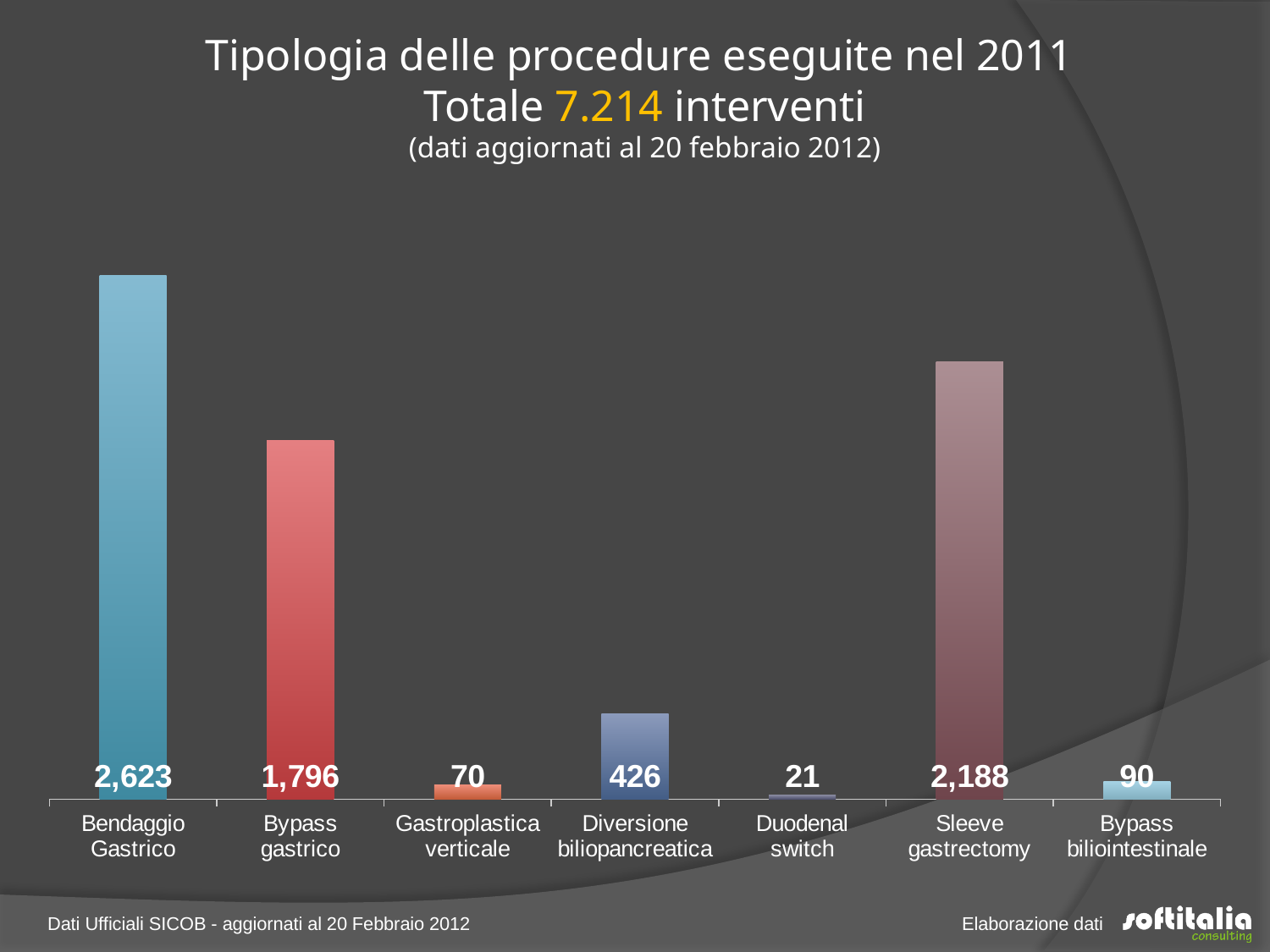
Which procedure has the lowest value? Duodenal switch What is the value for Duodenal switch? 21 What is the value for Sleeve gastrectomy? 2,188 How many procedure categories are shown in the chart? 7 What is the value for Diversione biliopancreatica? 426 What kind of chart is shown on the slide? Bar chart What is the difference between Bendaggio Gastrico and Bypass gastrico? 827 What total number of interventions does the chart title state? 7.214 Which is larger, Gastroplastica verticale or Bypass biliointestinale? Bypass biliointestinale What is the value for Bendaggio Gastrico? 2,623 Which procedure has the highest value? Bendaggio Gastrico What is the difference between Sleeve gastrectomy and Bypass gastrico? 392